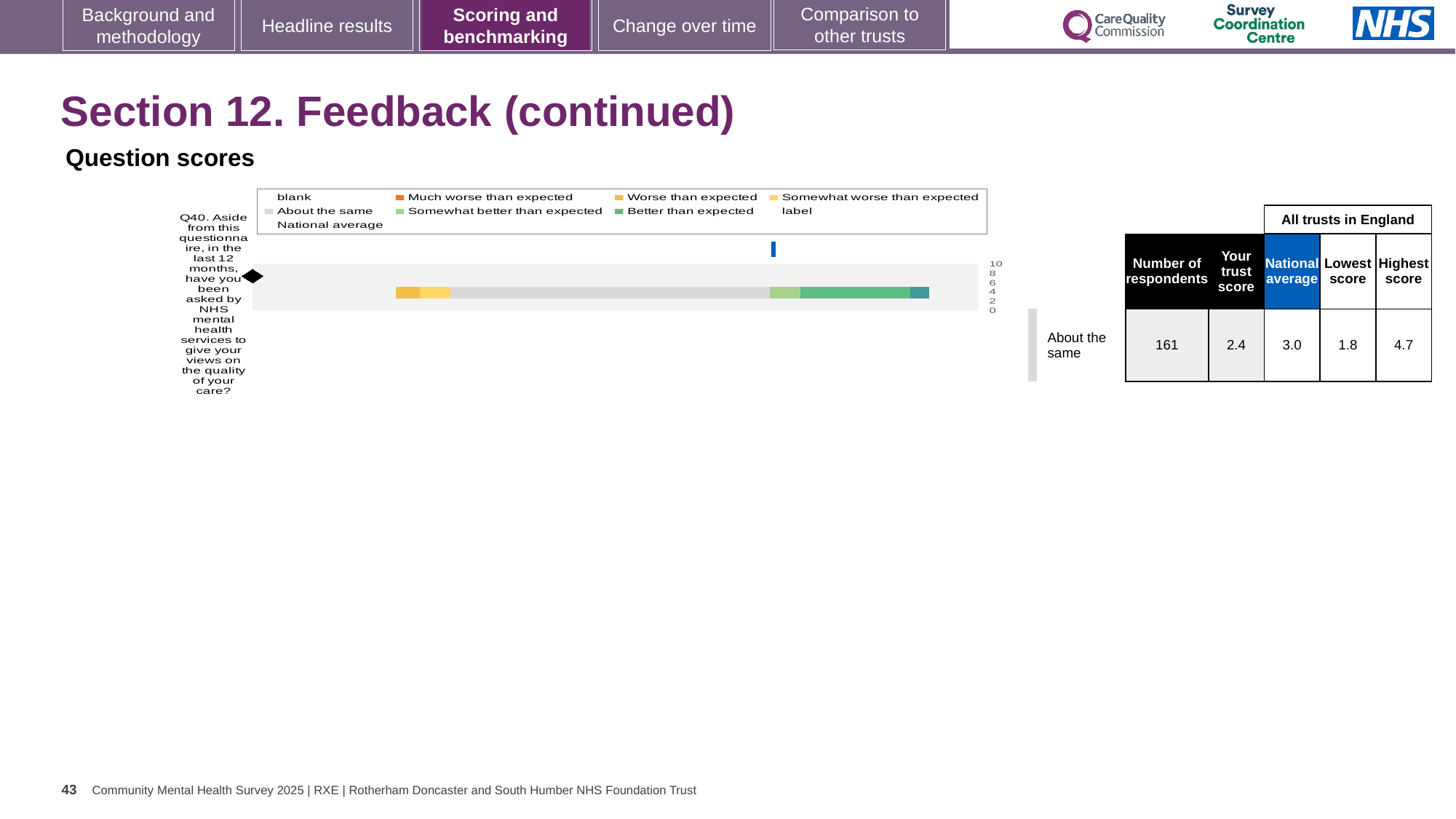
Which is larger for Q40: the trust's score or the national average? national average In the Q40 bar, is the 'Better than expected' segment wider or narrower than the 'Worse than expected' segment? wider According to the table beside the chart, how many respondents answered Q40? 161 What kind of chart is used to show the Q40 question score? bar chart What benchmark category is the trust's Q40 score assigned to, as shown next to the chart? About the same What is the difference between the highest score (4.7) and the lowest score (1.8) for Q40 in the table beside the chart? 2.9 How many entries does the chart's legend list? 9 According to the table beside the chart, what is the national average score for Q40? 3.0 Which legend category occupies the largest portion of the Q40 bar? About the same What colour represents 'Much worse than expected' in the chart legend? orange How many questions are plotted in the chart? 1 According to the table beside the chart, what is the trust's score for Q40? 2.4